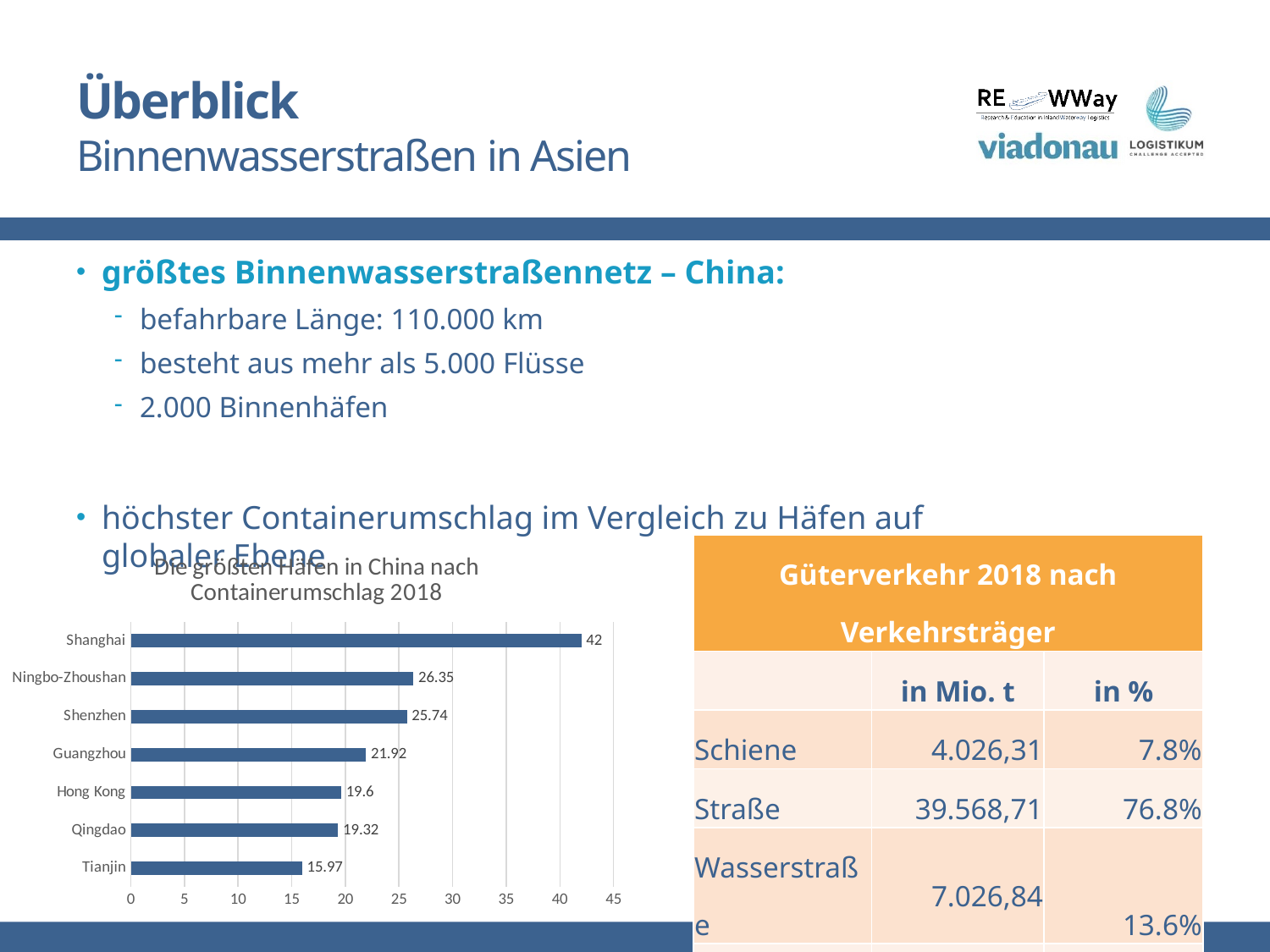
What is the title of the chart? Die größten Häfen in China nach Containerumschlag 2018 What is the difference between the values for Shanghai and Ningbo-Zhoushan? 15.65 What is the value for Tianjin in the chart? 15.97 Which has a larger value, Shenzhen or Guangzhou? Shenzhen What is the value for Guangzhou in the chart? 21.92 What is the value for Shanghai in the chart? 42 Which port has the lowest value in the chart? Tianjin How many ports are shown in the chart? 7 Is the value for Hong Kong greater or less than 20? less Which port has the highest value in the chart? Shanghai What kind of chart is shown on the slide? bar chart What is the value for Ningbo-Zhoushan in the chart? 26.35